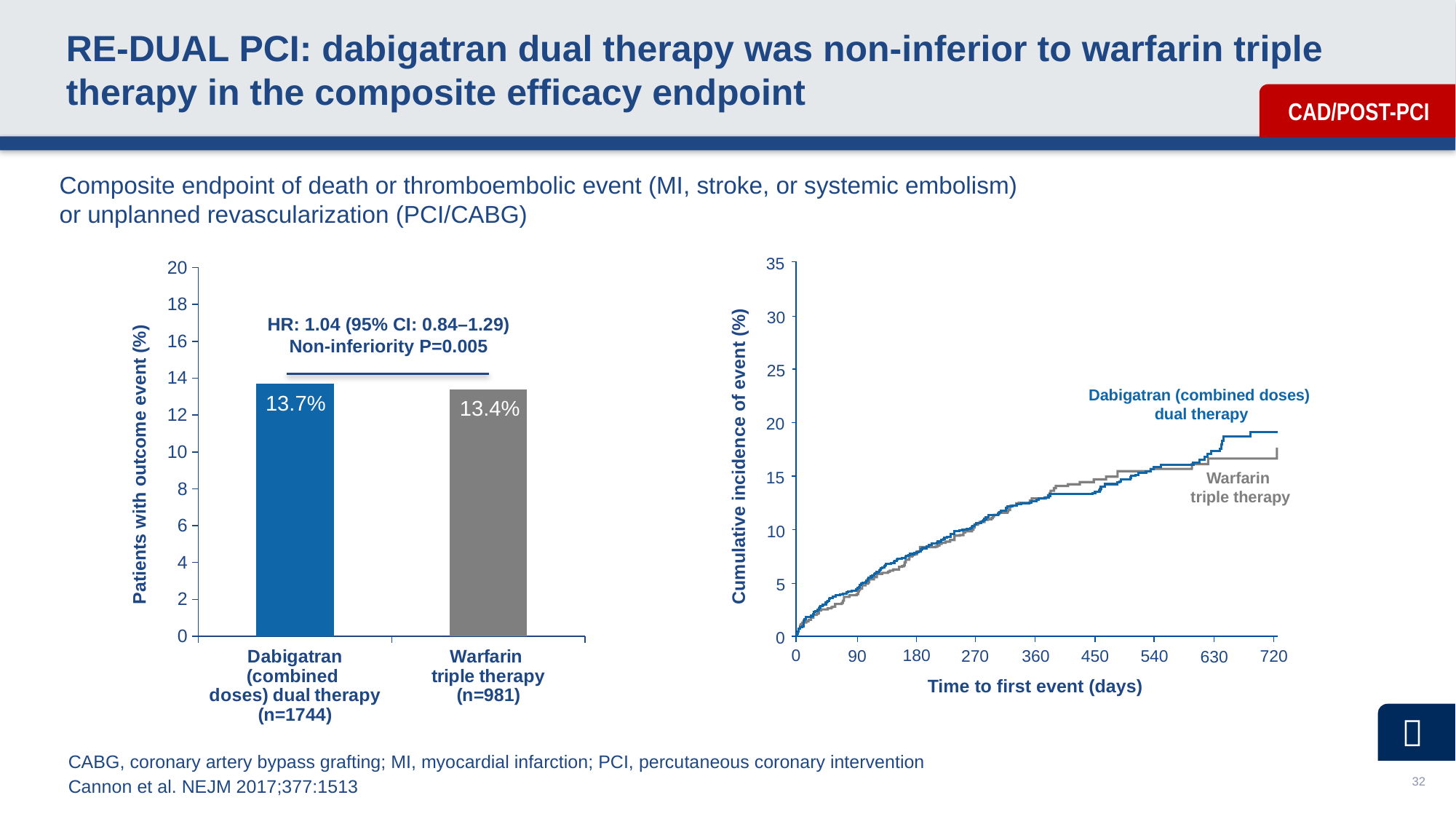
In the bar chart on the left, what hazard ratio is printed above the bars? HR: 1.04 (95% CI: 0.84–1.29) In the bar chart on the left, which treatment group has the higher percentage of patients with an outcome event? Dabigatran (combined doses) dual therapy In the cumulative incidence chart on the right, what is the label of the x axis? Time to first event (days) In the cumulative incidence chart on the right, does the cumulative incidence of event rise or fall as time to first event increases? Rise In the bar chart on the left, what is the difference in percentage points between the dabigatran dual therapy bar and the warfarin triple therapy bar? 0.3 In the cumulative incidence chart on the right, how many treatment groups are plotted? 2 In the cumulative incidence chart on the right, is the cumulative incidence for dabigatran dual therapy at 720 days greater or less than 15%? greater What type of chart is shown on the left side of the slide? Bar chart In the bar chart on the left, what is the maximum value shown on the y axis? 20 In the bar chart on the left, what percentage of patients had an outcome event with dabigatran (combined doses) dual therapy? 13.7% In the bar chart on the left, what percentage of patients had an outcome event with warfarin triple therapy? 13.4% In the bar chart on the left, how many bars are plotted? 2